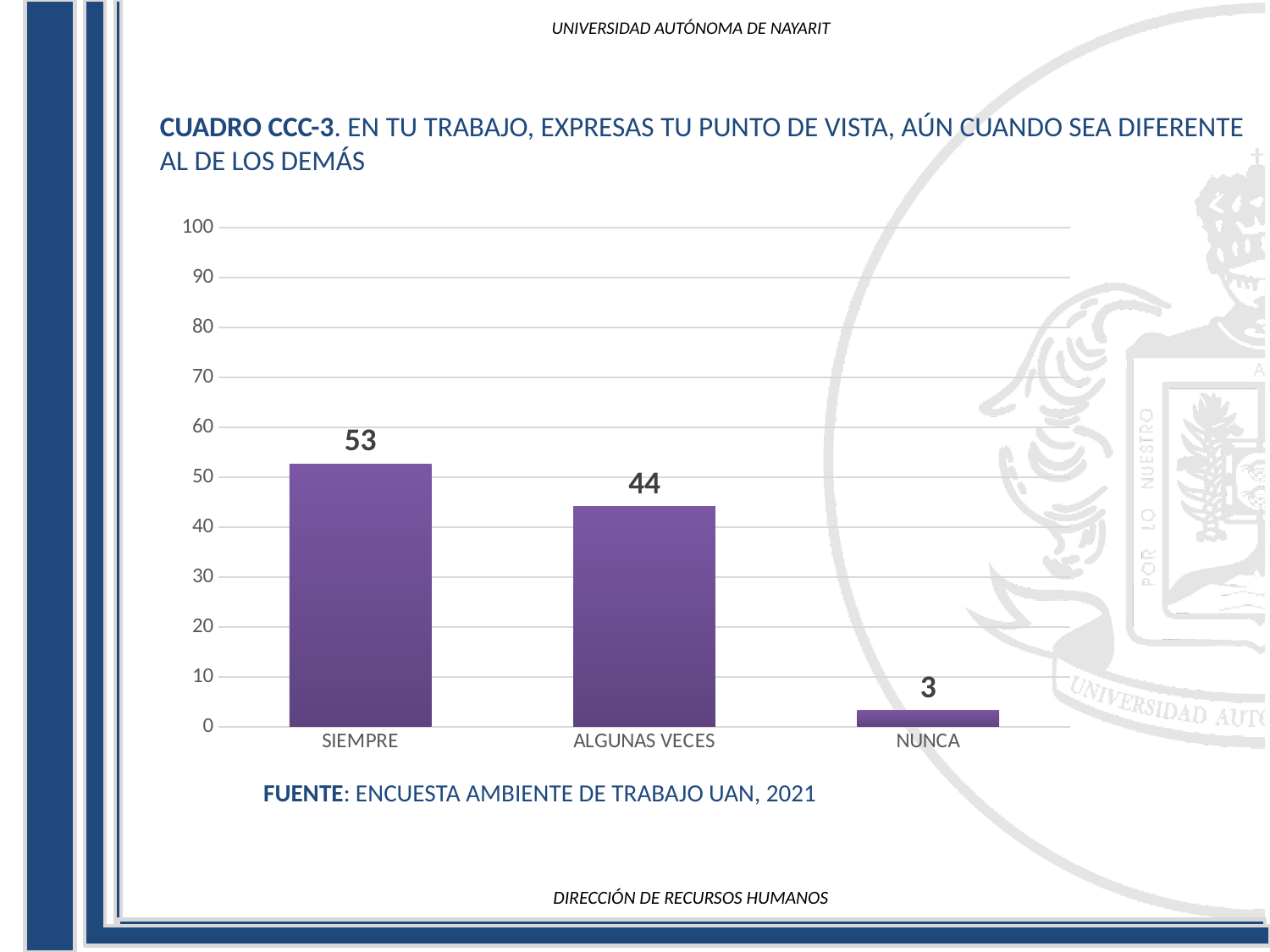
Which category has the highest value? SIEMPRE What kind of chart is shown on the slide? bar chart Is the value for ALGUNAS VECES greater or less than 50? less Which category has the lowest value? NUNCA What is the value for SIEMPRE? 53 How many categories are shown on the x axis? 3 What source is cited below the chart? ENCUESTA AMBIENTE DE TRABAJO UAN, 2021 What is the value for ALGUNAS VECES? 44 Which is larger, the value for SIEMPRE or the value for ALGUNAS VECES? SIEMPRE What is the difference between the values for ALGUNAS VECES and NUNCA? 41 What is the value for NUNCA? 3 What is the difference between the values for SIEMPRE and ALGUNAS VECES? 9